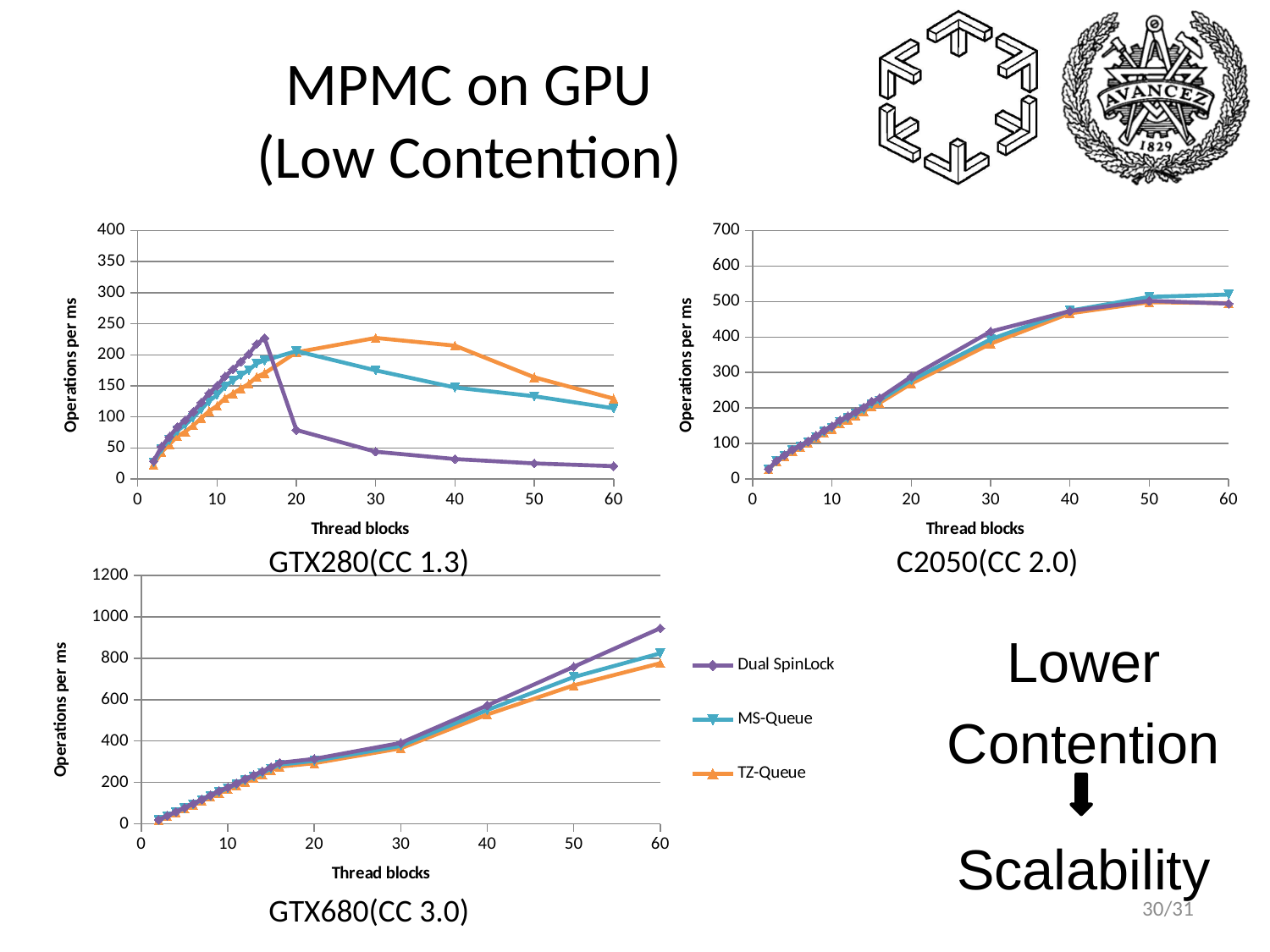
In the GTX280(CC 1.3) chart, is the value for TZ-Queue at 30 thread blocks greater or less than 200? greater How many series does the legend list for the charts on this slide? 3 What is the x-axis label on the GTX680(CC 3.0) chart? Thread blocks What kind of chart is the GTX280(CC 1.3) chart? line chart In the C2050(CC 2.0) chart, is the value for Dual SpinLock at 40 thread blocks greater or less than 500? less In the GTX680(CC 3.0) chart, which series has the highest value at 60 thread blocks? Dual SpinLock In the C2050(CC 2.0) chart, do the values generally rise or fall as thread blocks increase? rise In the GTX280(CC 1.3) chart, which series has the highest value at 30 thread blocks? TZ-Queue In the GTX280(CC 1.3) chart, which series has the lowest value at 40 thread blocks? Dual SpinLock In the GTX280(CC 1.3) chart, at 20 thread blocks, which is larger: Dual SpinLock or TZ-Queue? TZ-Queue In the GTX280(CC 1.3) chart, is the value for Dual SpinLock at 60 thread blocks greater or less than 50? less